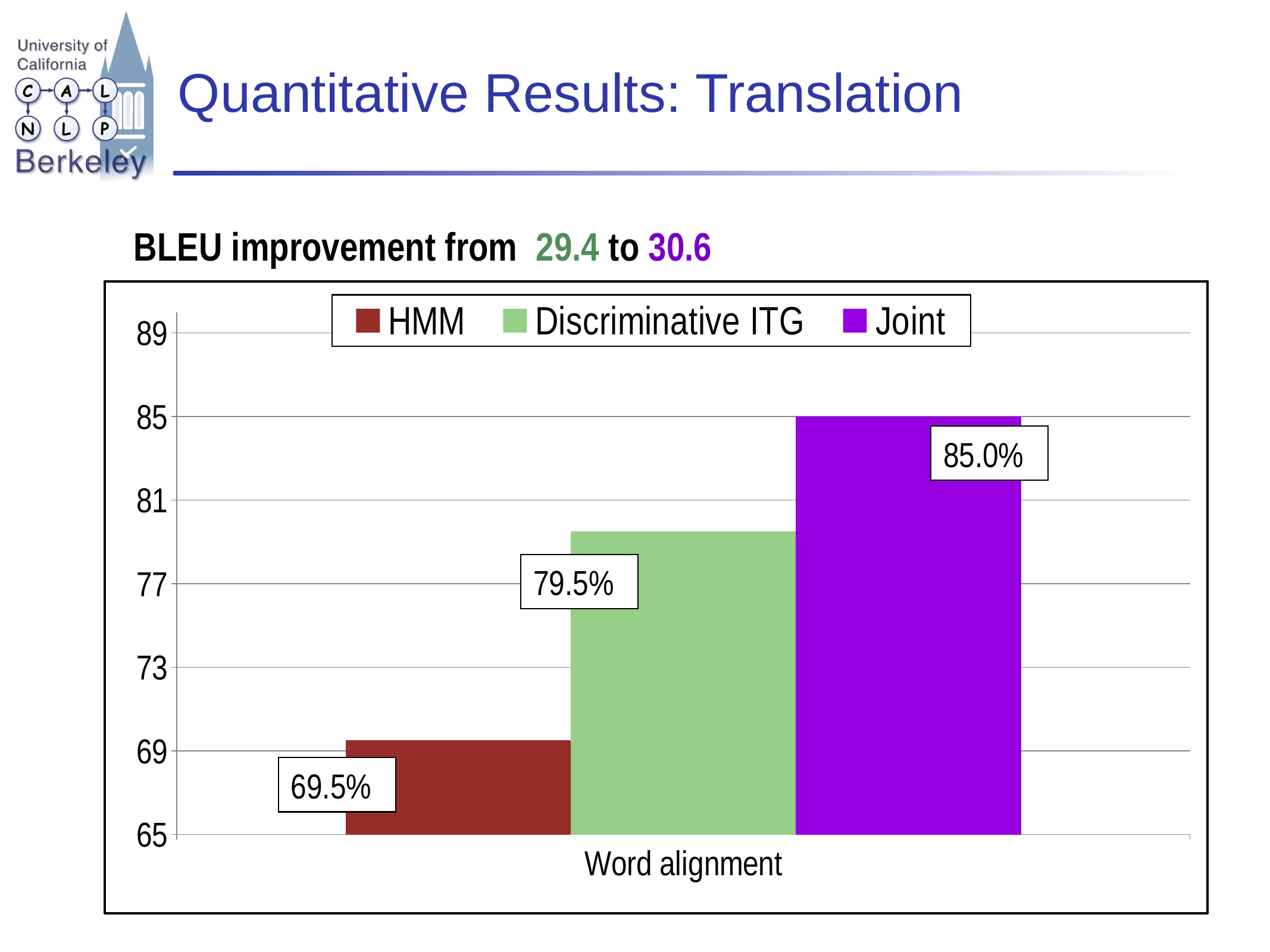
What kind of chart is shown on the slide? bar chart What is the value for HMM on the Word alignment chart? 69.5% How many series does the legend list? 3 Which is larger, the value for Discriminative ITG or the value for Joint? Joint What is the difference between the Discriminative ITG and HMM values? 10.0% Which series has the lowest value? HMM Is the value for Discriminative ITG greater or less than 81? less What is the value for Discriminative ITG? 79.5% Which series has the highest value? Joint What is the value for Joint? 85.0% What is the difference between the Joint and HMM values? 15.5% What is the category label on the x axis? Word alignment